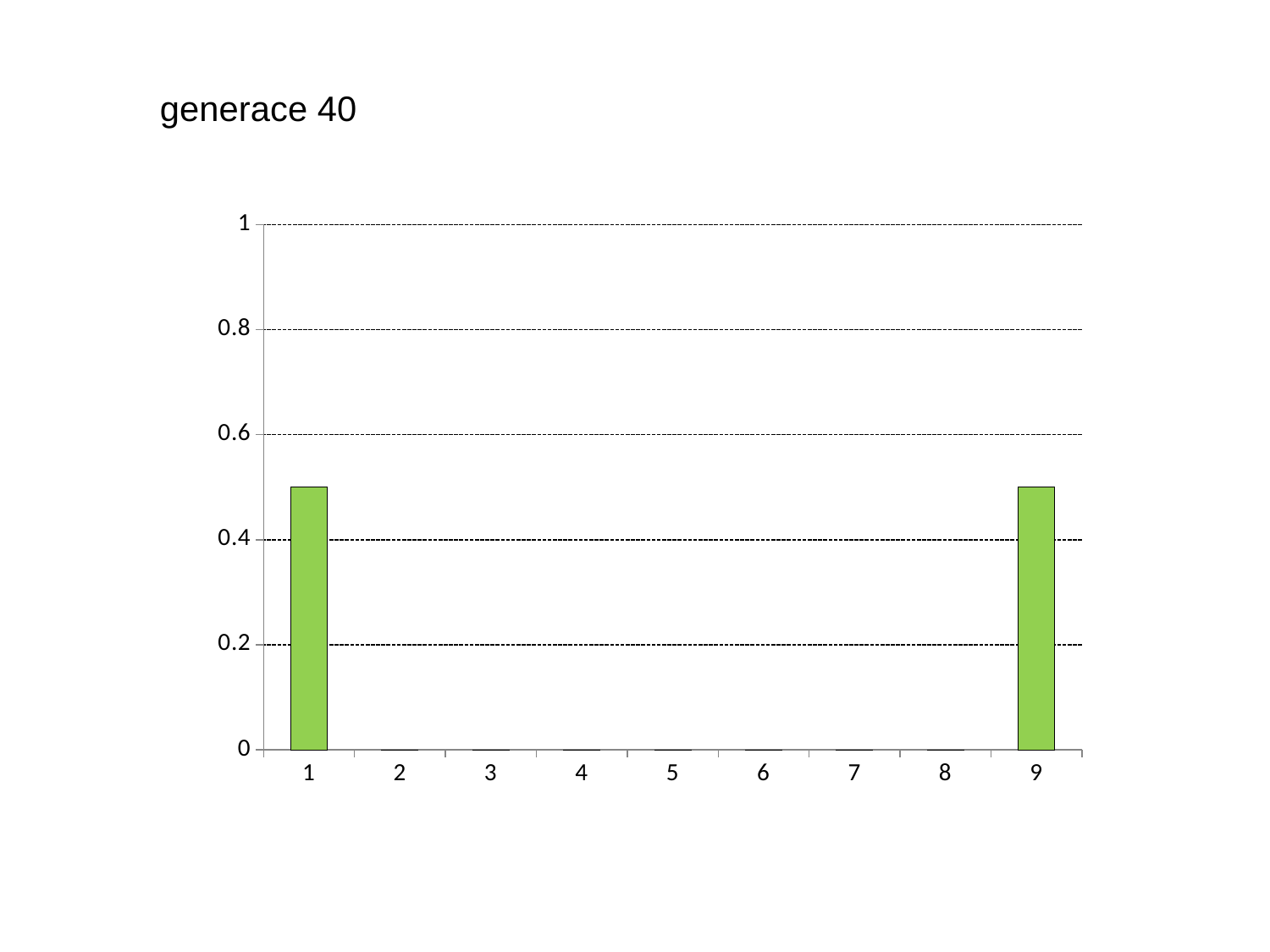
Is the value for category 1 greater or less than 0.6? less Is the value for category 5 greater or less than 0.2? less What kind of chart is shown on the slide? bar chart What is the highest value shown on the y axis? 1 What colour are the bars in the chart? green Is the value for category 1 greater or less than 0.4? greater What is the title of the chart? generace 40 How many categories are shown on the x axis? 9 Which is larger, the value for category 1 or the value for category 5? category 1 Which is larger, the value for category 9 or the value for category 3? category 9